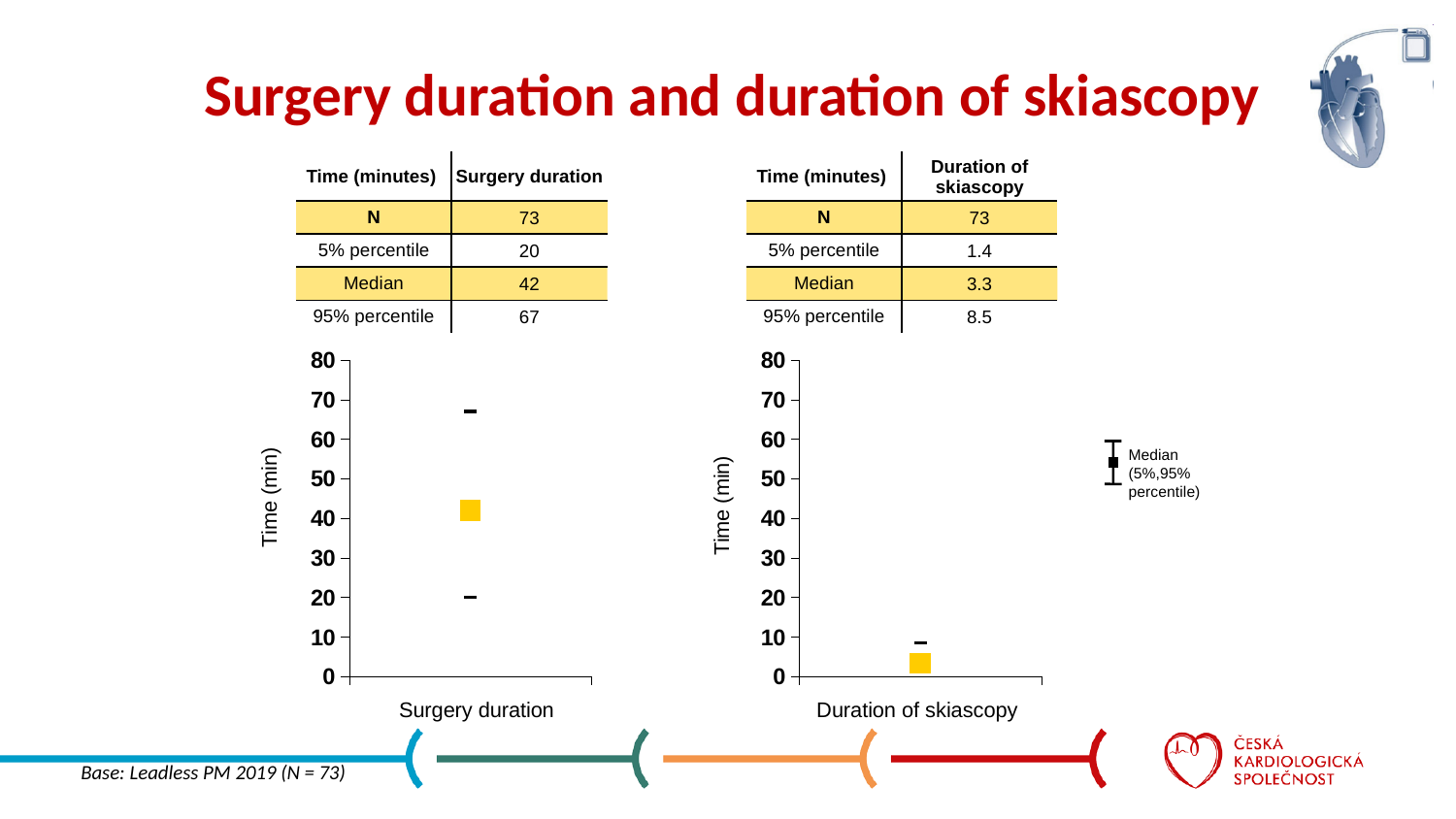
In the Surgery duration chart, what is the difference between the 95% percentile and the 5% percentile? 47 In the Duration of skiascopy chart, is the 95% percentile value greater or less than 10? less What is the N (number of cases) shown for the Surgery duration chart? 73 What is the y-axis label on both charts? Time (min) According to the legend, what do the black markers above and below the yellow square represent? 5%, 95% percentile In the Surgery duration chart, is the median value greater or less than 40? greater In the Duration of skiascopy chart, what is the difference between the 95% percentile and the median? 5.2 Which is larger: the median surgery duration or the median duration of skiascopy? Median surgery duration In the Duration of skiascopy chart, what is the median duration of skiascopy in minutes? 3.3 In the Surgery duration chart, what is the 95% percentile value? 67 In the Duration of skiascopy chart, what is the 5% percentile value? 1.4 In the Surgery duration chart, what is the median surgery duration in minutes? 42